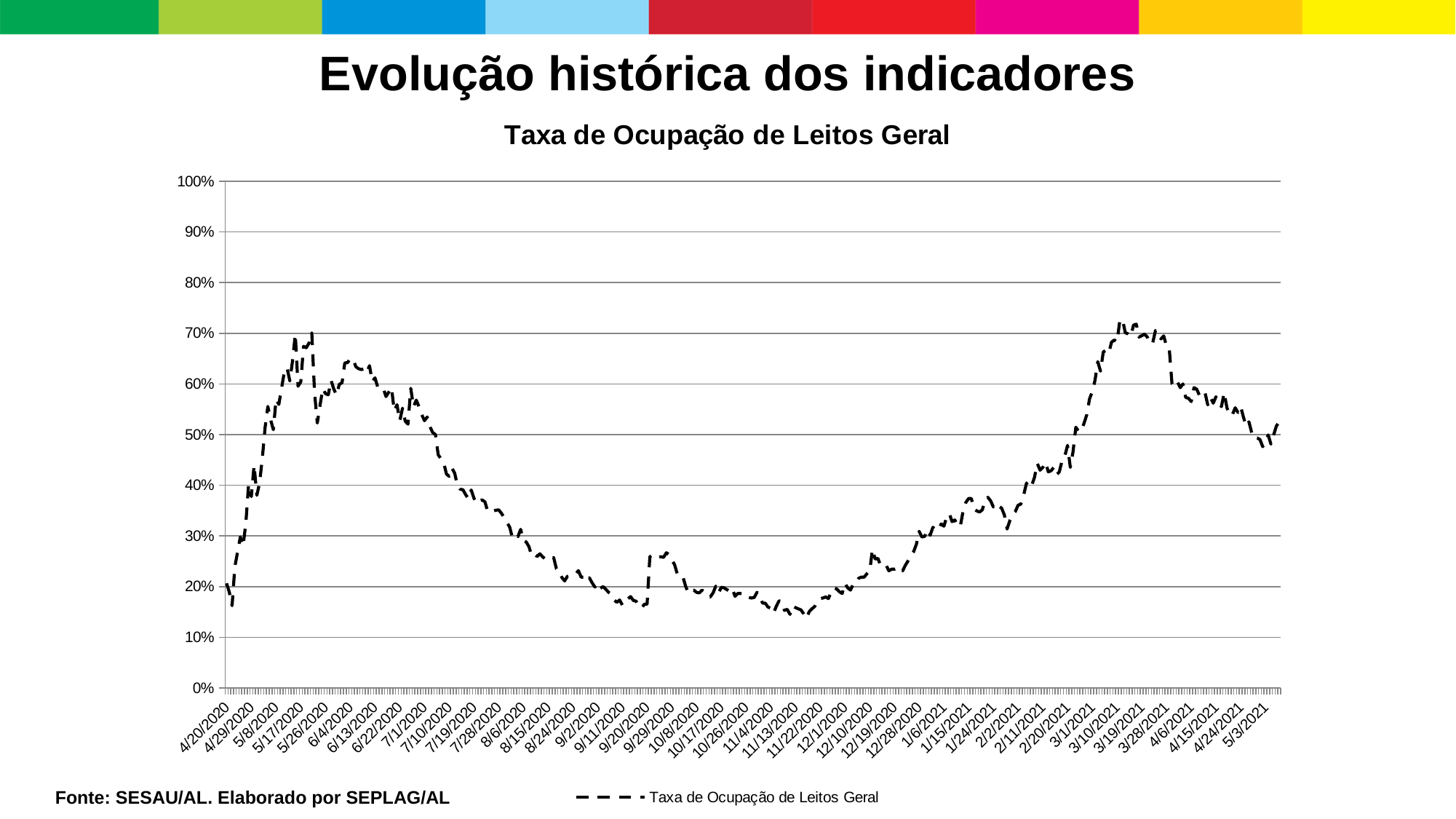
Is the value for 3/19/2021 greater or less than 60%? greater How many series does the legend list? 1 Which is larger, the value for 3/19/2021 or the value for 11/13/2020? 3/19/2021 Is the value for 7/1/2020 greater or less than 40%? greater Is the value for 5/3/2021 greater or less than 40%? greater Does the occupancy rate rise or fall between 6/13/2020 and 9/11/2020? fall What is the source cited below the chart? SESAU/AL. Elaborado por SEPLAG/AL What is the title of the chart? Taxa de Ocupação de Leitos Geral Does the occupancy rate rise or fall between 11/13/2020 and 3/10/2021? rise What kind of chart is shown on the slide? line chart